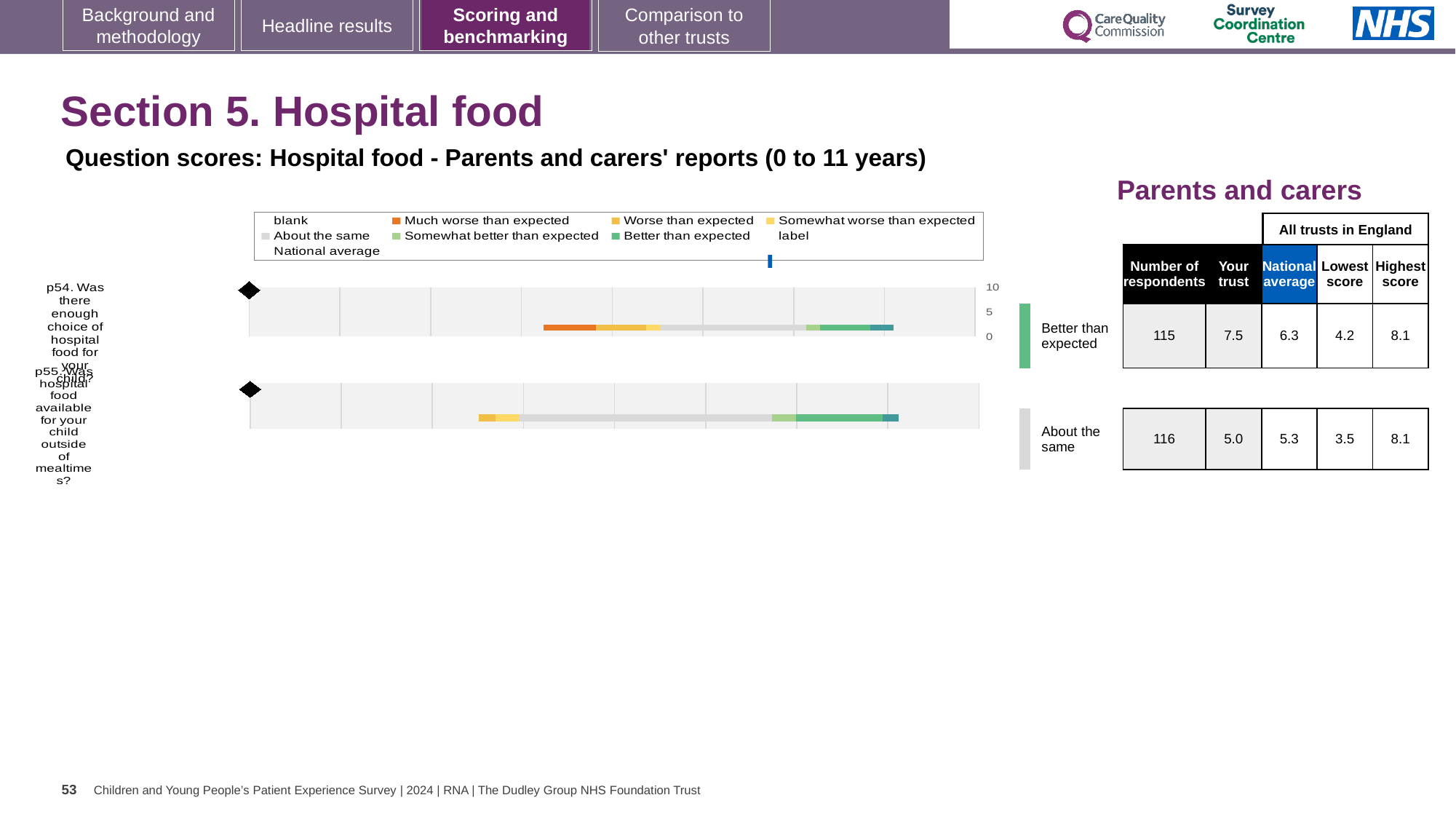
In the table beside the chart, what is the 'National average' for the row labelled 'About the same'? 5.3 In the table beside the chart, what is the difference between the 'Your trust' score and the 'National average' for the row labelled 'Better than expected'? 1.2 In the table beside the chart, what is the highest score for the row labelled 'About the same'? 8.1 How many questions (bars) are plotted in the chart? 2 In the table beside the chart, what is the number of respondents for the row labelled 'Better than expected'? 115 What kind of chart is shown on the slide? bar chart In the table beside the chart, what is the lowest score for the row labelled 'Better than expected'? 4.2 In the table beside the chart, for the row labelled 'Better than expected', which is larger: the 'Your trust' score or the 'National average'? Your trust What colour represents 'About the same' in the chart legend? grey How many entries does the chart's legend list? 9 What colour represents 'Much worse than expected' in the chart legend? orange In the table beside the chart, what is the 'Your trust' score for the row labelled 'Better than expected'? 7.5